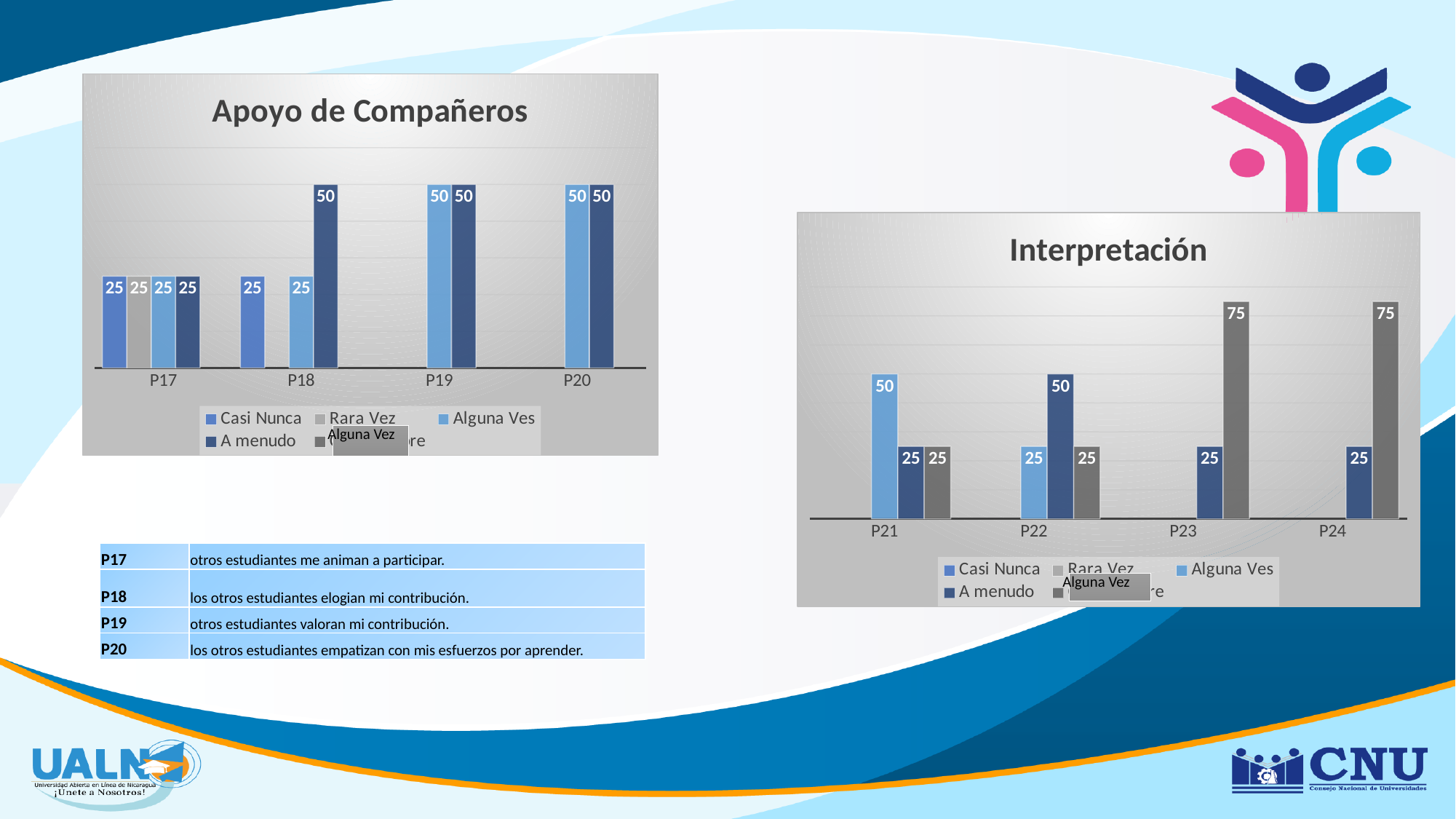
In the 'Apoyo de Compañeros' chart, how many categories are shown on the x axis? 4 In the 'Apoyo de Compañeros' chart, what is the value for A menudo at P18? 50 In the 'Interpretación' chart, what is the difference between A menudo at P22 and A menudo at P21? 25 In the 'Interpretación' chart, what is the value for A menudo at P22? 50 What kind of chart is the 'Apoyo de Compañeros' chart? bar chart In the 'Apoyo de Compañeros' chart, what is the value for Rara Vez at P17? 25 In the 'Apoyo de Compañeros' chart, which is larger: A menudo at P17 or A menudo at P18? P18 In the 'Interpretación' chart, what is the highest value shown on any bar? 75 In the 'Apoyo de Compañeros' chart, what is the difference between A menudo and Casi Nunca at P18? 25 In the 'Apoyo de Compañeros' chart, how many series does the legend list? 5 What is the title of the chart on the right side of the slide? Interpretación In the 'Interpretación' chart, what is the value for Alguna Ves at P21? 50